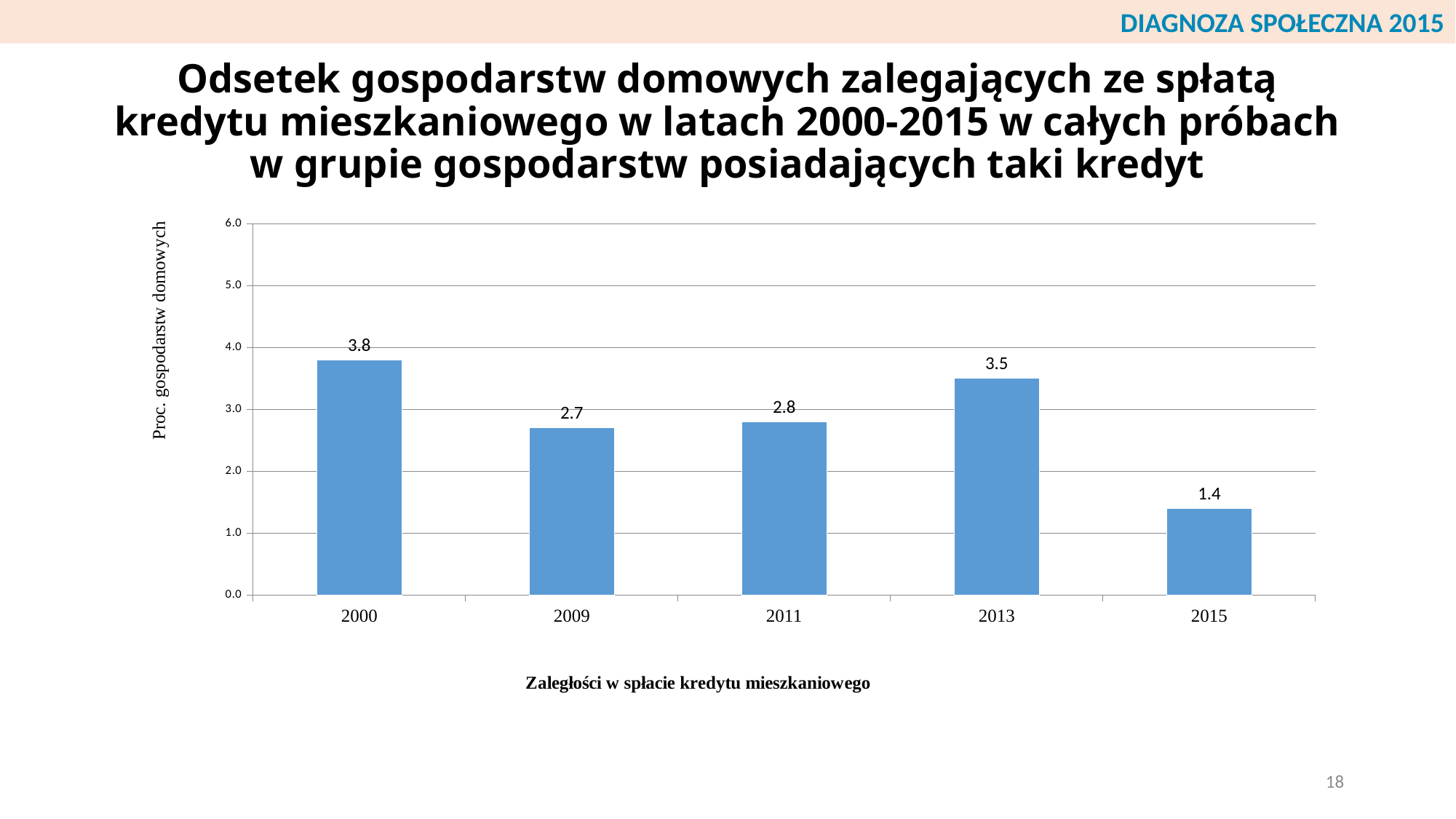
Which is larger, the value for 2009 or the value for 2013? 2013 What is the difference between the values for 2000 and 2015? 2.4 How many years are shown on the x axis? 5 Which year has the lowest value? 2015 What is the value for 2013? 3.5 Which year has the highest value? 2000 What is the label on the y axis? Proc. gospodarstw domowych What is the value for 2015? 1.4 What is the value for 2000? 3.8 Is the value for 2013 greater or less than 3.0? greater What is the difference between the values for 2013 and 2011? 0.7 What kind of chart is shown on the slide? bar chart